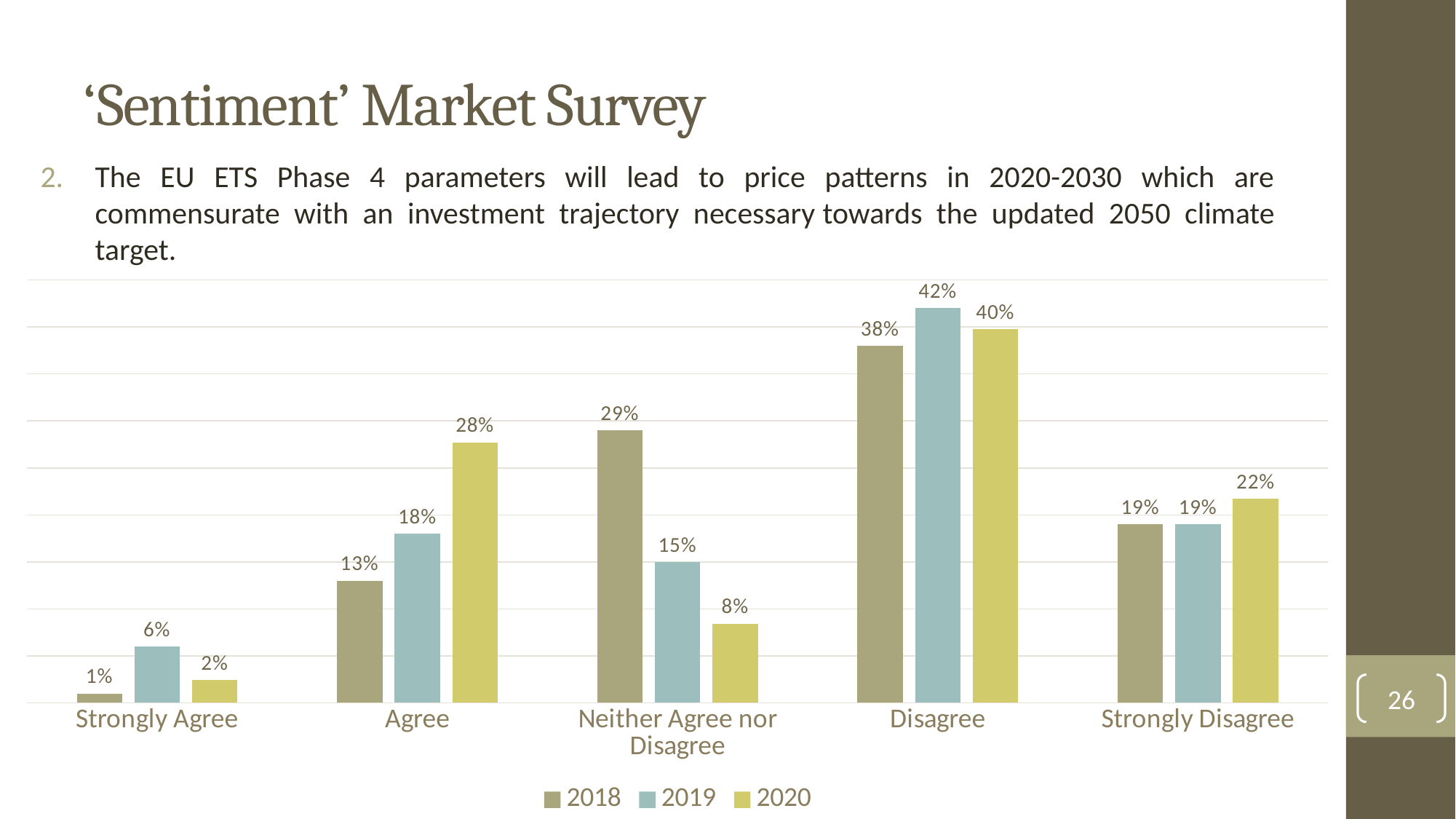
What kind of chart is shown on the slide? Bar chart What is the difference between the 2020 and 2018 values for Agree? 15% How many response categories are shown on the x axis? 5 What is the 2018 value for Neither Agree nor Disagree? 29% Which is larger for Strongly Disagree: the 2020 value or the 2018 value? 2020 What is the 2018 value for Strongly Agree? 1% How many series does the legend list? 3 What is the difference between the 2018 and 2020 values for Neither Agree nor Disagree? 21% Which category has the highest 2020 value? Disagree Which category has the lowest 2019 value? Strongly Agree What is the 2020 value for Agree? 28% What is the 2019 value for Disagree? 42%